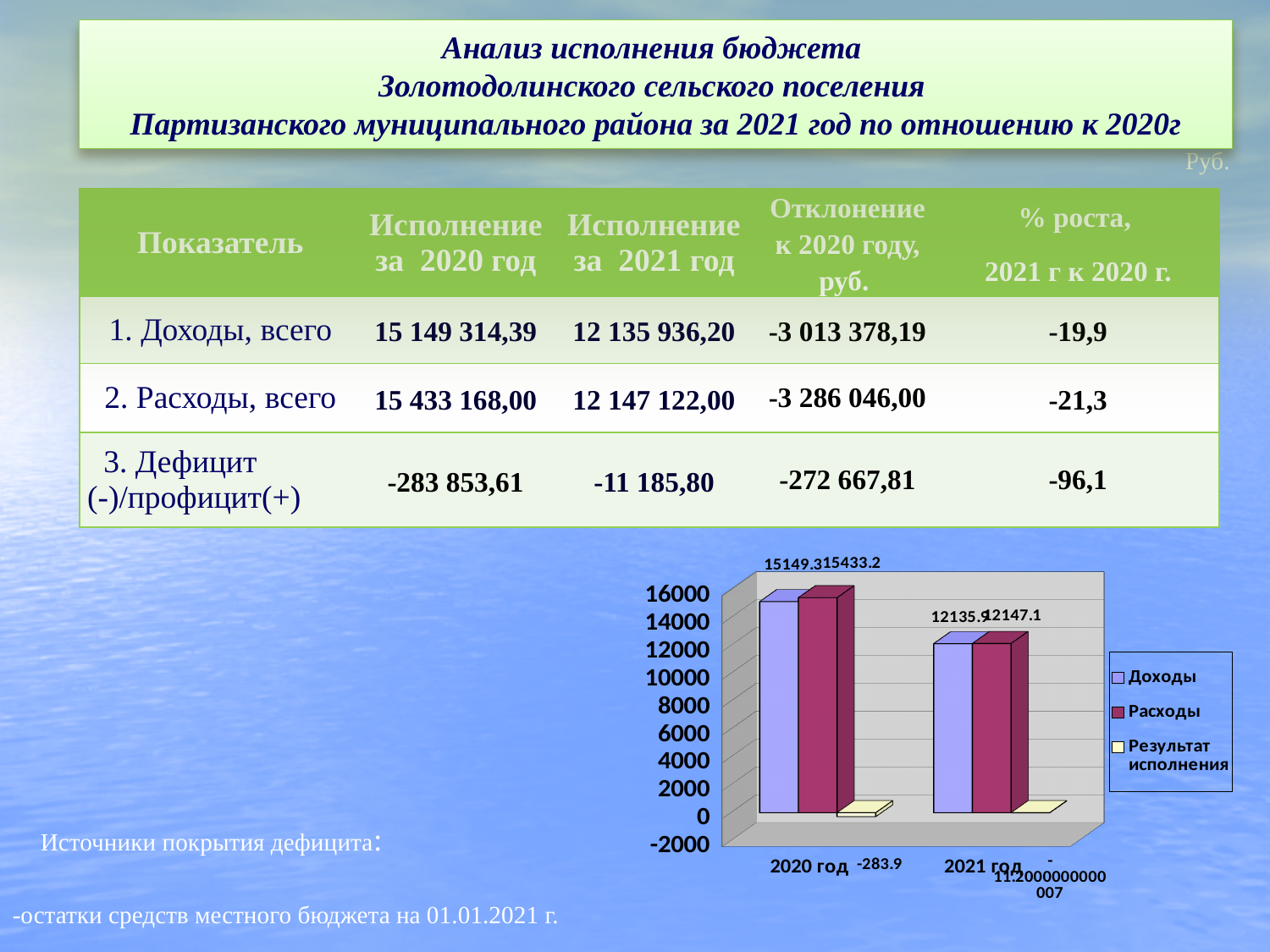
Which is larger for 2020 год, Доходы or Расходы? Расходы What is the difference between Доходы for 2020 год and Доходы for 2021 год? 3013.4 How many series does the chart legend list? 3 Is the value of Доходы for 2021 год greater or less than 14000? less What is the value of Доходы for 2021 год in the chart? 12135.9 What is the value of Доходы for 2020 год in the chart? 15149.3 What is the value of Расходы for 2020 год in the chart? 15433.2 How many categories (years) are shown on the x axis of the chart? 2 Do the Доходы values rise or fall from 2020 год to 2021 год? fall What is the value of Результат исполнения for 2020 год in the chart? -283.9 What kind of chart is shown on the slide? bar chart What is the value of Расходы for 2021 год in the chart? 12147.1